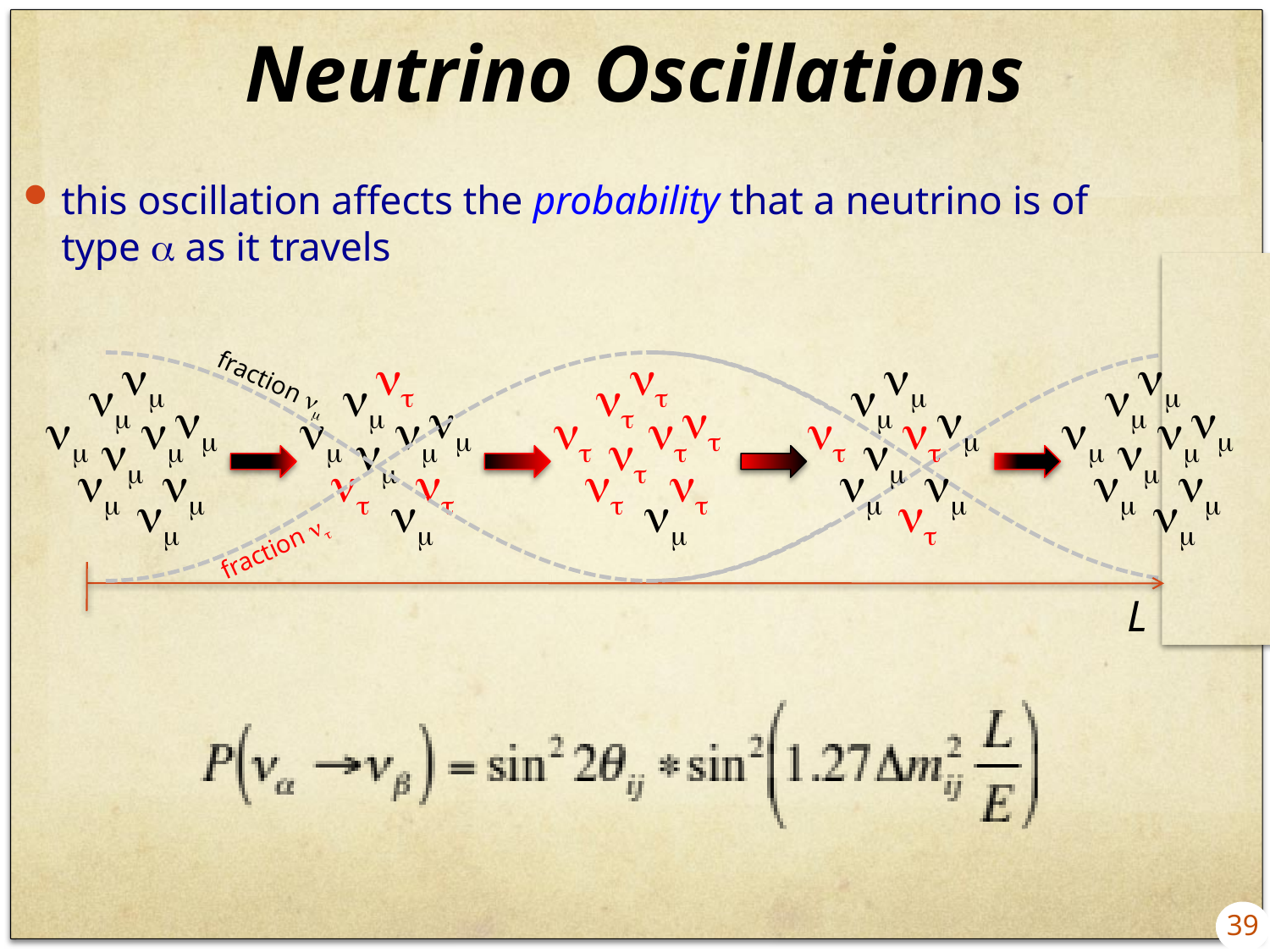
How many groups of neutrino symbols are shown along the axis in the diagram? 5 Does the fraction ν_μ curve rise or fall as L increases from the left end of the axis? fall Which curve is higher at the middle of the axis, fraction ν_μ or fraction ν_τ? fraction ν_τ How many arrows connect the groups of neutrino symbols in the diagram? 4 What are the two dashed curves in the diagram labeled? fraction ν_μ and fraction ν_τ Which curve is higher at the left end of the axis, fraction ν_μ or fraction ν_τ? fraction ν_μ How many dashed curves are drawn in the diagram? 2 Does the fraction ν_τ curve rise or fall as L increases from the left end of the axis? rise What is the horizontal axis of the diagram labeled? L